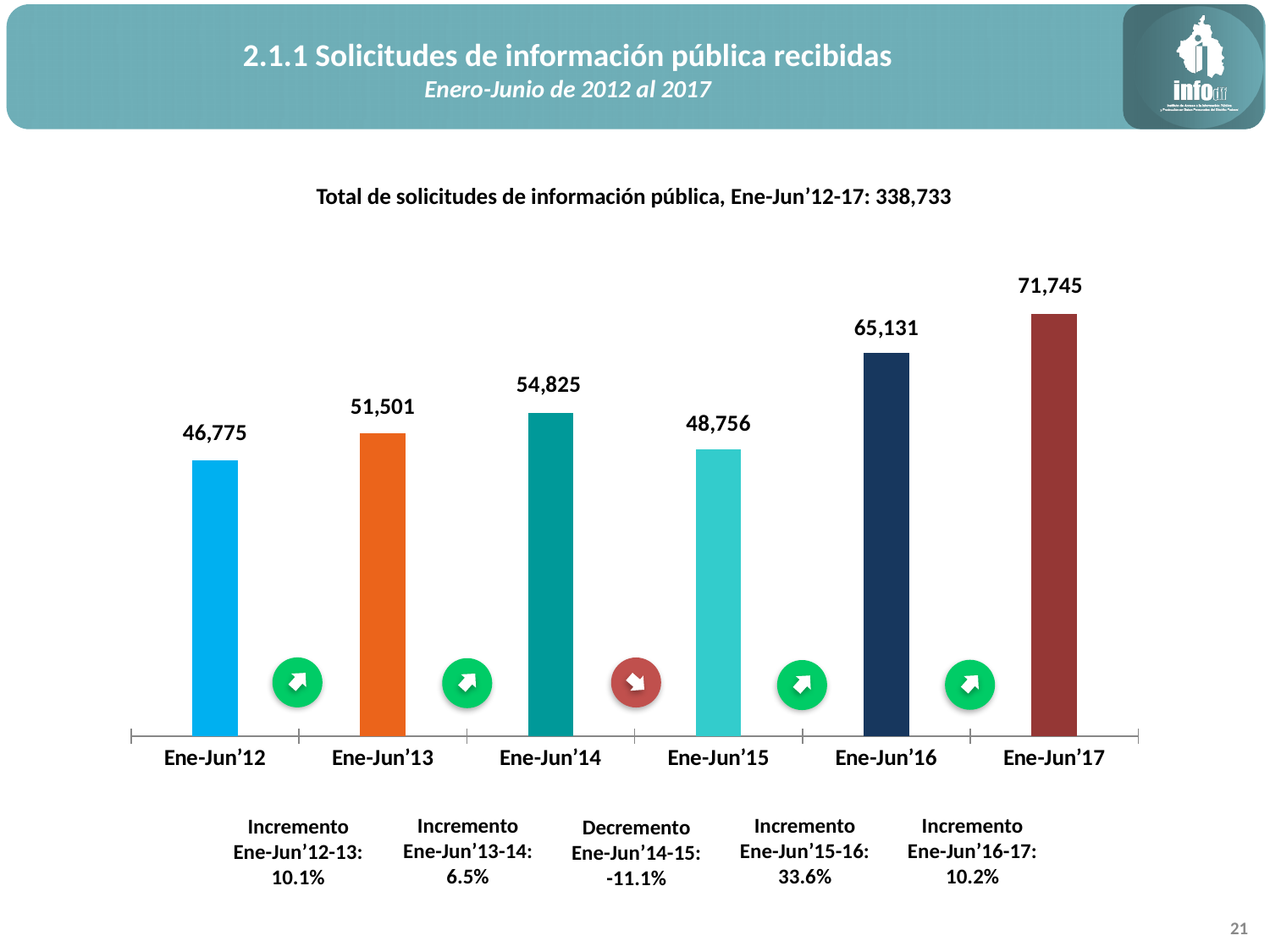
What is the total of solicitudes de información pública for Ene-Jun'12-17 stated on the slide? 338,733 What is the difference between the values for Ene-Jun'14 and Ene-Jun'15? 6,069 Which period has the lowest value? Ene-Jun'12 How many periods are shown on the x axis? 6 What percentage change is shown between Ene-Jun'15 and Ene-Jun'16? 33.6% Which is larger, the value for Ene-Jun'13 or the value for Ene-Jun'15? Ene-Jun'13 What is the value for Ene-Jun'15? 48,756 What is the value for Ene-Jun'12? 46,775 Which period has the highest value? Ene-Jun'17 What is the difference between the values for Ene-Jun'17 and Ene-Jun'16? 6,614 What is the value for Ene-Jun'17? 71,745 What kind of chart is shown on the slide? Bar chart